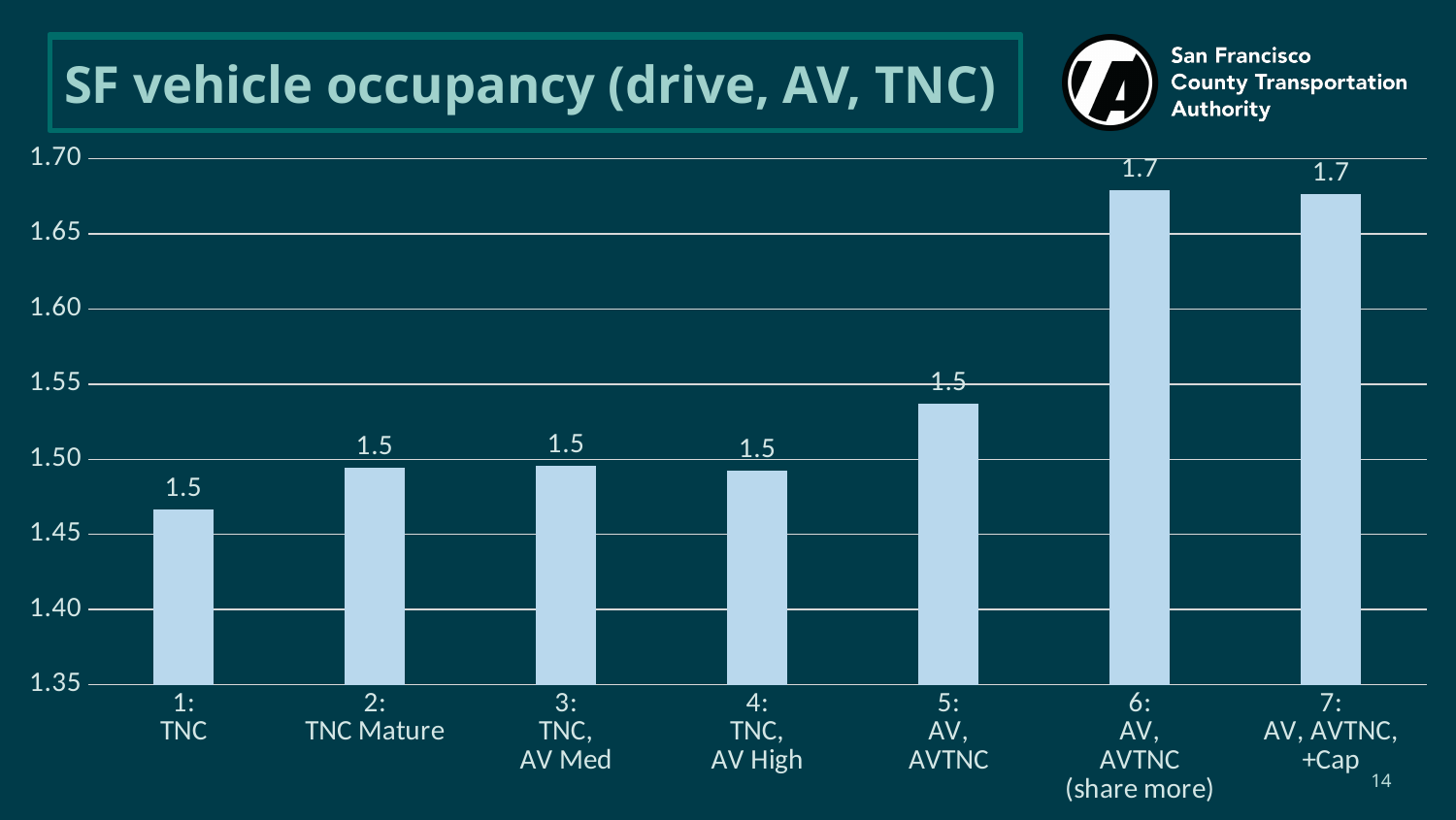
What is the value shown for the "6: AV, AVTNC (share more)" bar? 1.7 How many categories (bars) are shown in the chart? 7 Which category has the lowest bar? 1: TNC What is the difference between the labelled values for "6: AV, AVTNC (share more)" and "5: AV, AVTNC"? 0.2 What is the value shown for the "1: TNC" bar? 1.5 What is the value shown for the "7: AV, AVTNC, +Cap" bar? 1.7 What is the title of the slide? SF vehicle occupancy (drive, AV, TNC) What kind of chart is shown on the slide? Bar chart Is the value for "5: AV, AVTNC" greater or less than 1.50? greater Is the value for "6: AV, AVTNC (share more)" greater or less than 1.65? greater Is the value for "1: TNC" greater or less than 1.50? less Which bar is taller: "5: AV, AVTNC" or "4: TNC, AV High"? 5: AV, AVTNC